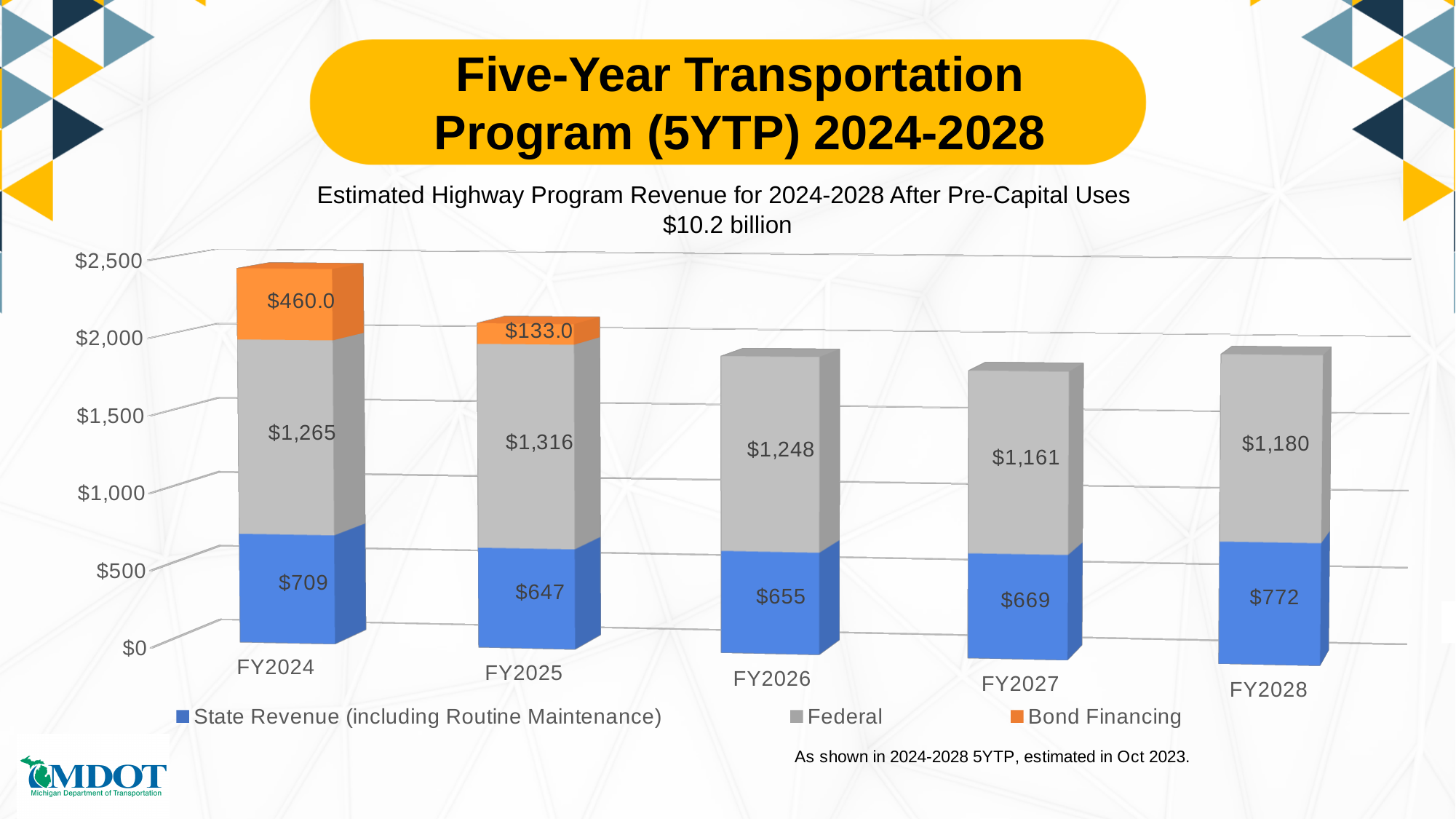
What is the State Revenue (including Routine Maintenance) value for FY2024? $709 Is the total stacked bar for FY2024 greater or less than $2,000? greater What is the Federal value for FY2027? $1,161 Which fiscal year has the lowest State Revenue (including Routine Maintenance) value? FY2025 Which fiscal year has the highest Federal value? FY2025 Which is larger, the State Revenue value for FY2028 or for FY2026? FY2028 What kind of chart is shown on the slide? Stacked bar chart What is the Bond Financing value for FY2025? $133.0 How many fiscal years are shown on the x axis? 5 What is the difference between the Federal values for FY2025 and FY2024? $51 How many series does the legend list? 3 What is the total of the stacked bar for FY2028? $1,952